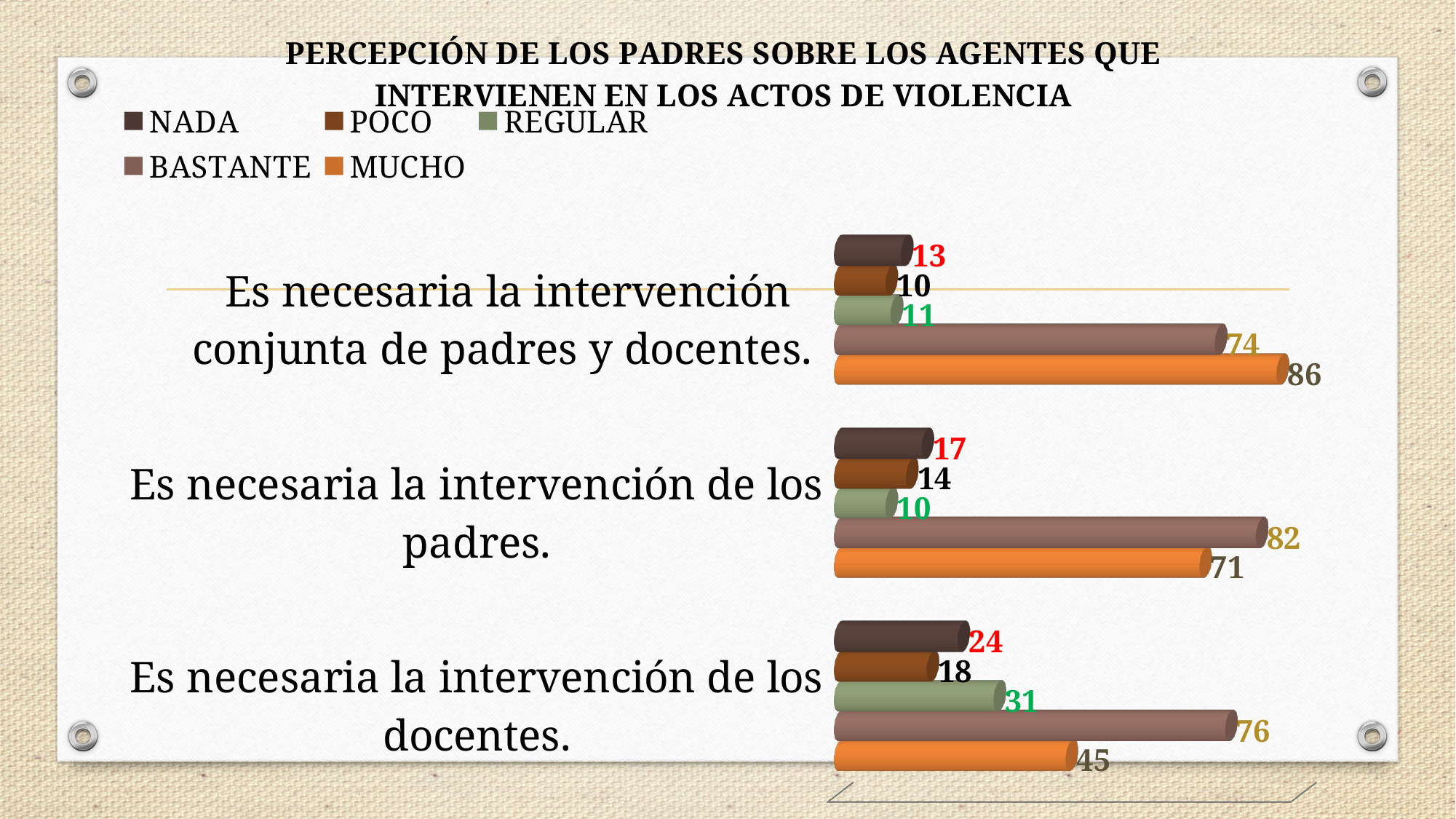
For "Es necesaria la intervención de los padres.", which is larger: BASTANTE or MUCHO? BASTANTE What is the difference between the BASTANTE and MUCHO values for "Es necesaria la intervención de los docentes."? 31 How many categories are shown on the chart? 3 What is the BASTANTE value for "Es necesaria la intervención de los padres."? 82 What is the NADA value for "Es necesaria la intervención de los docentes."? 24 Which series is shown in orange in the legend? MUCHO Which category has the lowest POCO value? Es necesaria la intervención conjunta de padres y docentes. What kind of chart is shown on the slide? Bar chart Which category has the highest MUCHO value? Es necesaria la intervención conjunta de padres y docentes. What is the REGULAR value for "Es necesaria la intervención de los docentes."? 31 How many series does the legend list? 5 What is the MUCHO value for "Es necesaria la intervención conjunta de padres y docentes."? 86